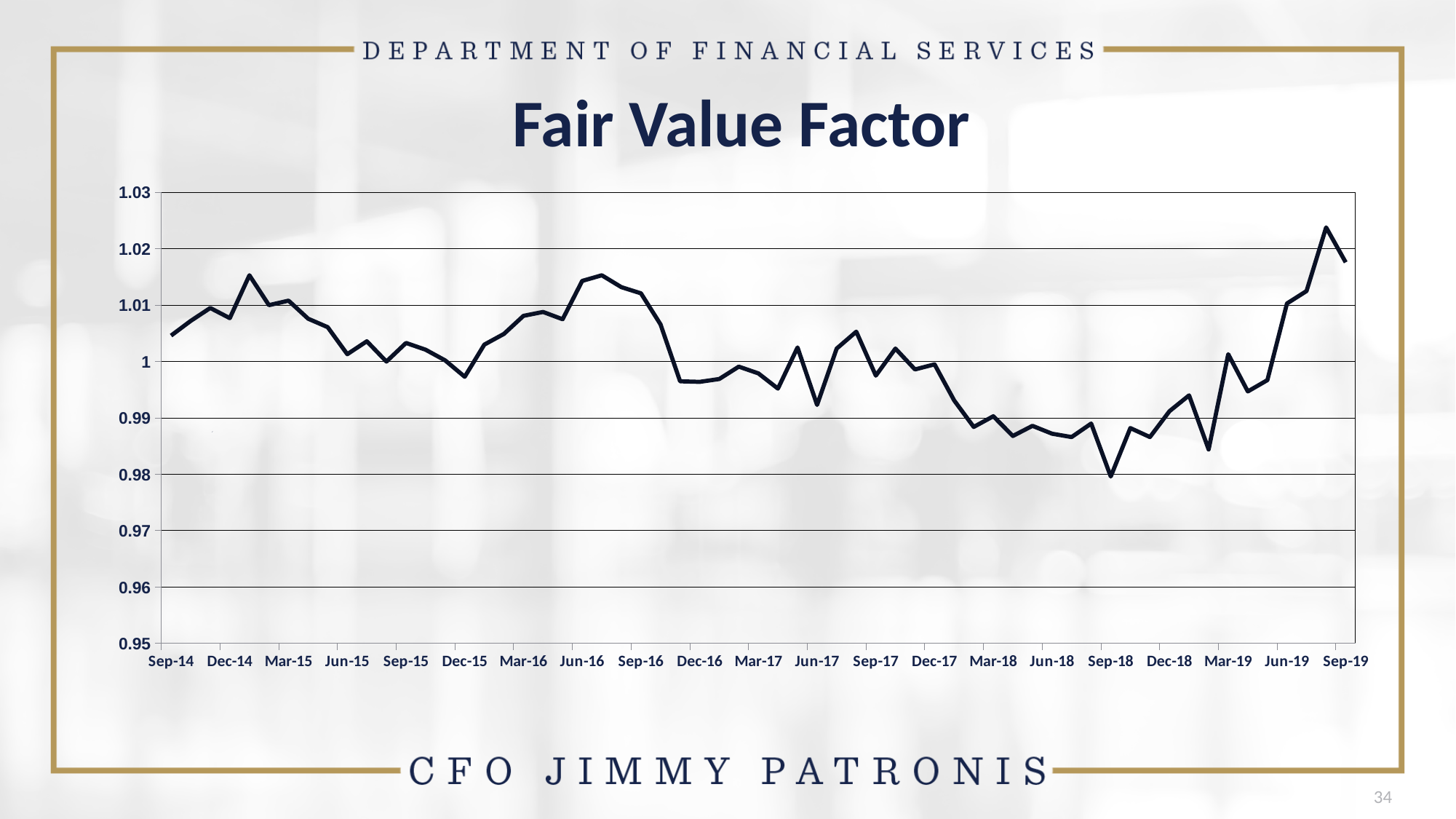
How many date labels are shown along the x axis? 21 What is the title of the chart? Fair Value Factor Which labelled date on the x axis has the lowest value on the line? Sep-18 What are the lowest and highest values shown on the y axis? 0.95 and 1.03 Is the value at Dec-16 greater or less than 1? less What kind of chart is shown on the slide? Line chart Is the value at Dec-14 greater or less than 1? greater Is the value at Sep-14 greater or less than 1? greater Which is larger, the value at Sep-14 or the value at Sep-18? Sep-14 Does the line rise or fall between Jun-19 and Sep-19? Rises